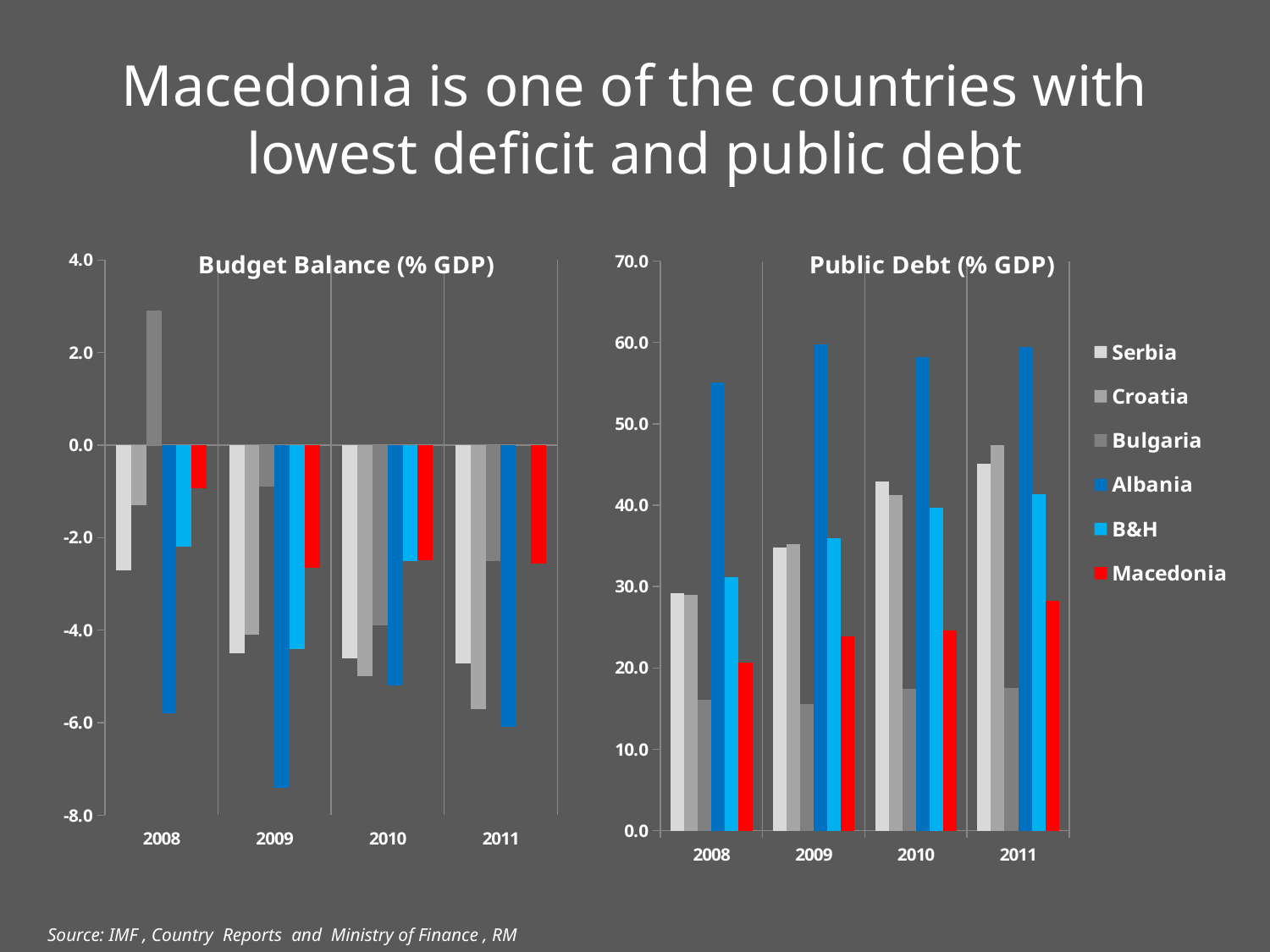
How many series does the legend list for the Public Debt (% GDP) chart? 6 In the Public Debt (% GDP) chart, is the value for Albania in 2009 greater or less than 50.0? greater In the Budget Balance (% GDP) chart, which country has the lowest budget balance in 2009? Albania Which colour represents Macedonia in the charts? red How many years are shown on the x axis of the Public Debt (% GDP) chart? 4 In the Public Debt (% GDP) chart, is the value for Macedonia in 2011 greater or less than 40.0? less In the Budget Balance (% GDP) chart, is the value for Albania in 2009 greater or less than -6.0? less In the Budget Balance (% GDP) chart, which country is the only one with a positive budget balance in 2008? Bulgaria What type of chart is the Budget Balance (% GDP) chart? bar chart In the Public Debt (% GDP) chart, which is larger in 2010, the value for Albania or the value for Macedonia? Albania In the Public Debt (% GDP) chart, does Macedonia's public debt rise or fall from 2008 to 2011? rise In the Public Debt (% GDP) chart, which country has the highest public debt in 2009? Albania